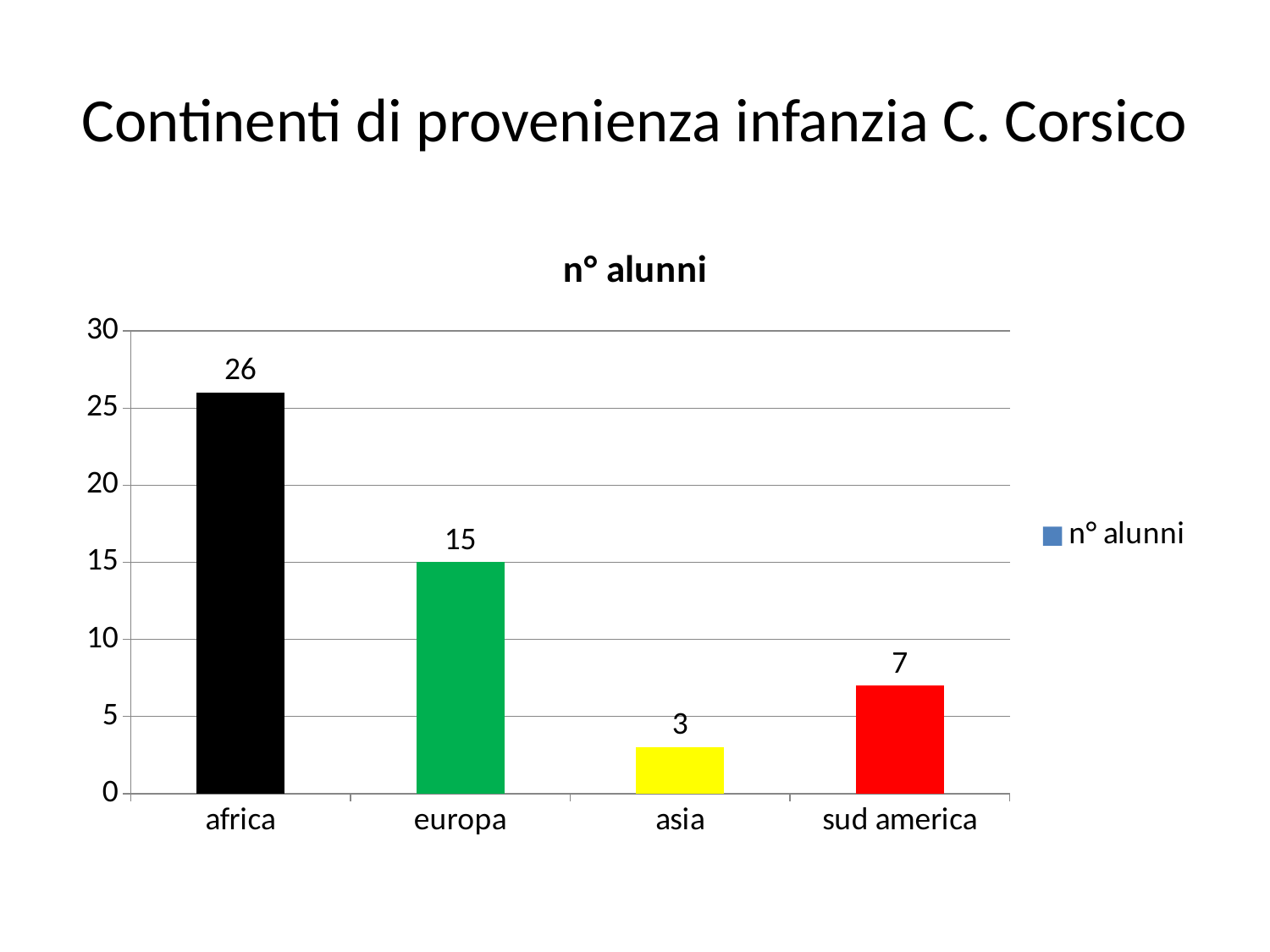
How many categories are shown on the x axis? 4 What kind of chart is shown on the slide? bar chart Is the value for europa greater or less than 20? less What is the difference between the values for africa and europa? 11 Which category has the highest value? africa What is the value for africa? 26 What is the value for sud america? 7 Which is larger, the value for sud america or the value for asia? sud america What is the value for asia? 3 Which category has the lowest value? asia What is the value for europa? 15 What is the title of the chart? n° alunni